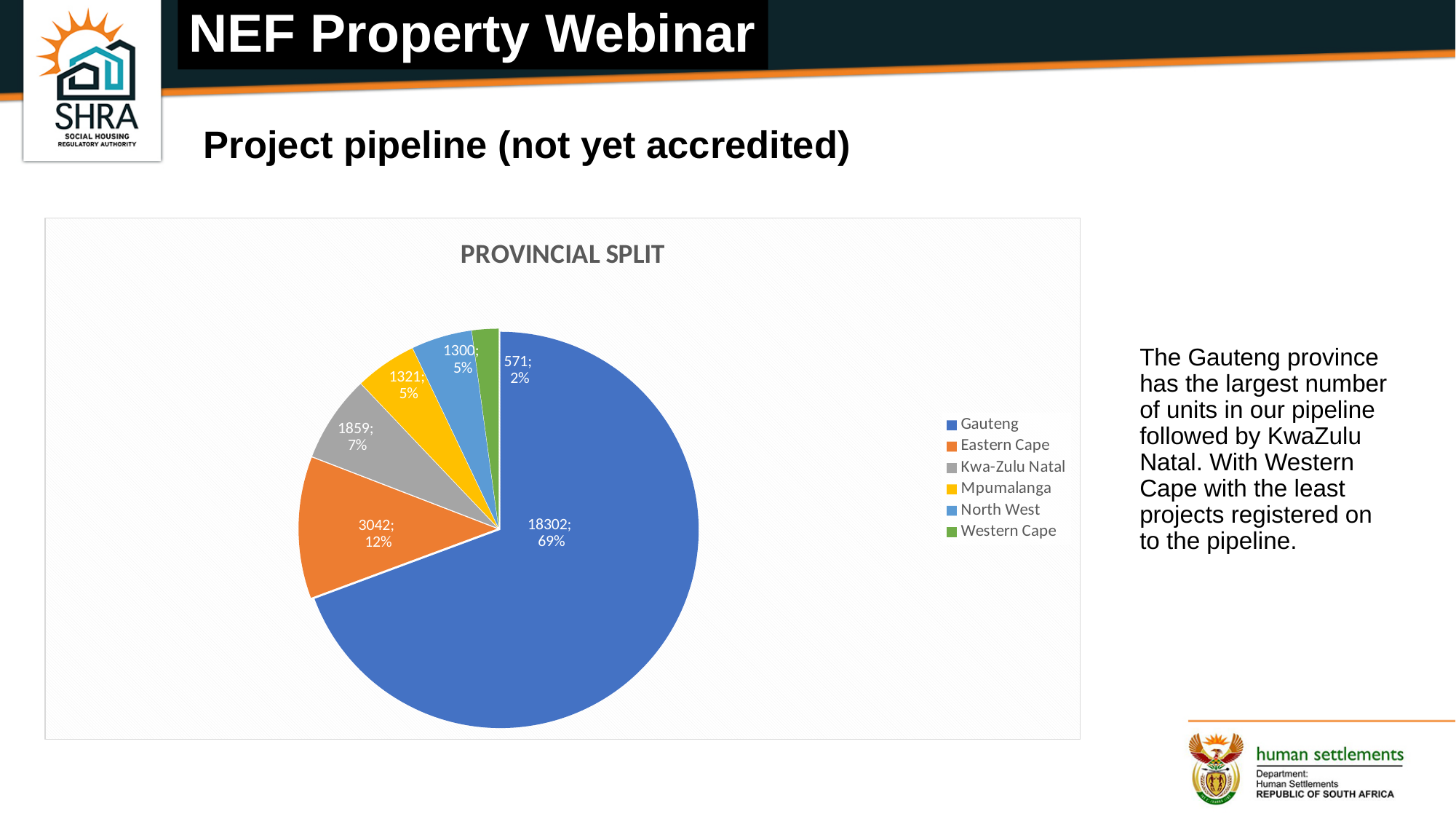
Which is larger, the value for Mpumalanga or the value for North West? Mpumalanga Which province has the largest slice? Gauteng What is the title of the chart? PROVINCIAL SPLIT What is the difference between the values for Eastern Cape and Kwa-Zulu Natal? 1183 What is the value for Kwa-Zulu Natal? 1859 What percentage share of the pie does Gauteng have? 69% What percentage share of the pie does Western Cape have? 2% Which province has the smallest slice? Western Cape What is the value for Eastern Cape? 3042 How many provinces are shown in the pie chart? 6 What type of chart is shown on the slide? pie chart What is the value for Gauteng? 18302